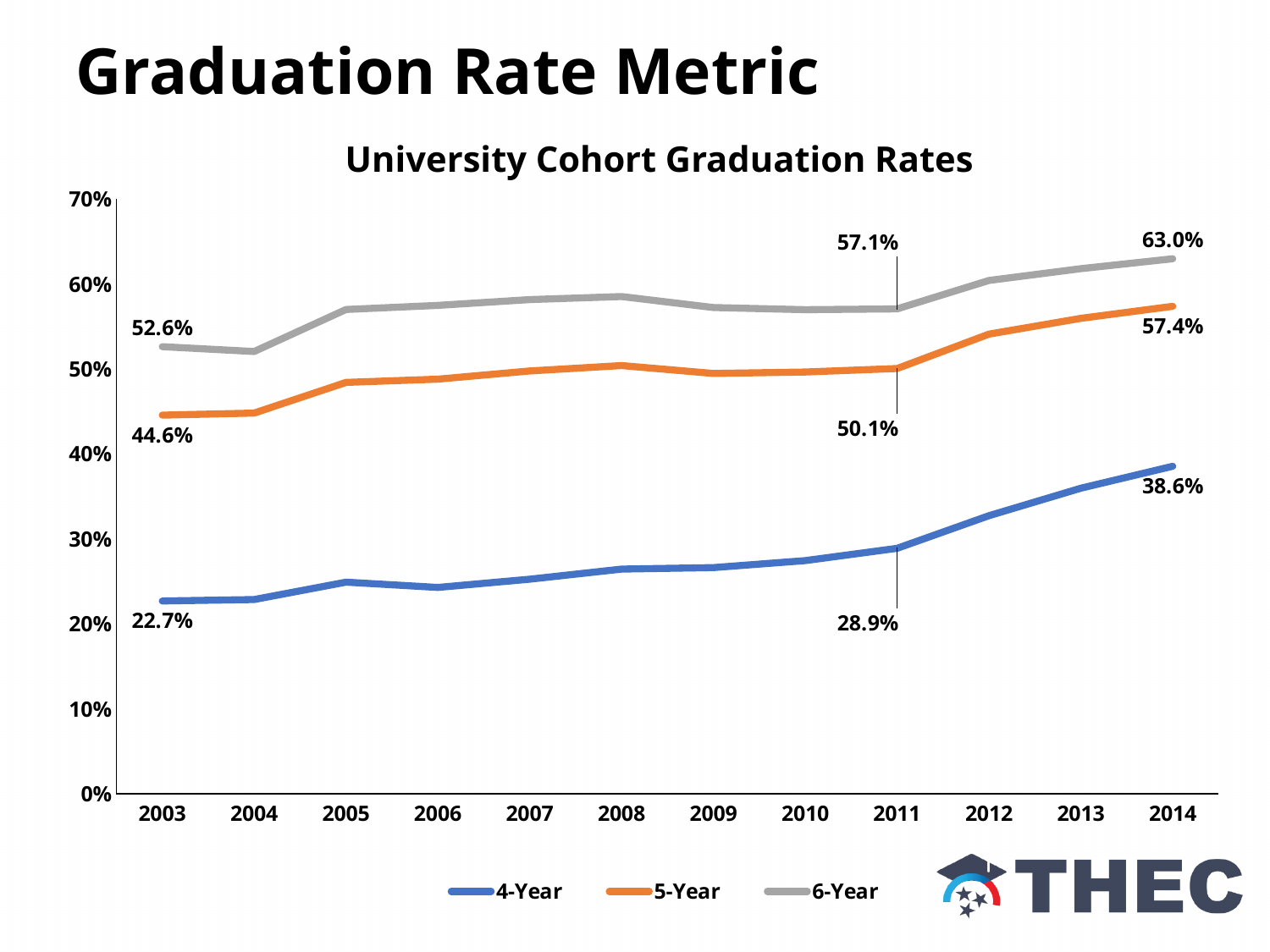
How many series does the legend list? 3 How many years are shown on the x axis? 12 What kind of chart is shown on the slide? Line chart What is the 4-Year graduation rate in 2003? 22.7% What is the title of the chart? University Cohort Graduation Rates What is the 4-Year graduation rate in 2014? 38.6% Is the 5-Year graduation rate in 2008 greater or less than 40%? greater What is the 5-Year graduation rate in 2011? 50.1% Does the 6-Year graduation rate rise or fall from 2011 to 2014? Rise By how many percentage points did the 4-Year graduation rate change from 2003 to 2014? 15.9 percentage points What is the 6-Year graduation rate in 2014? 63.0% Which series has the highest value in 2014? 6-Year